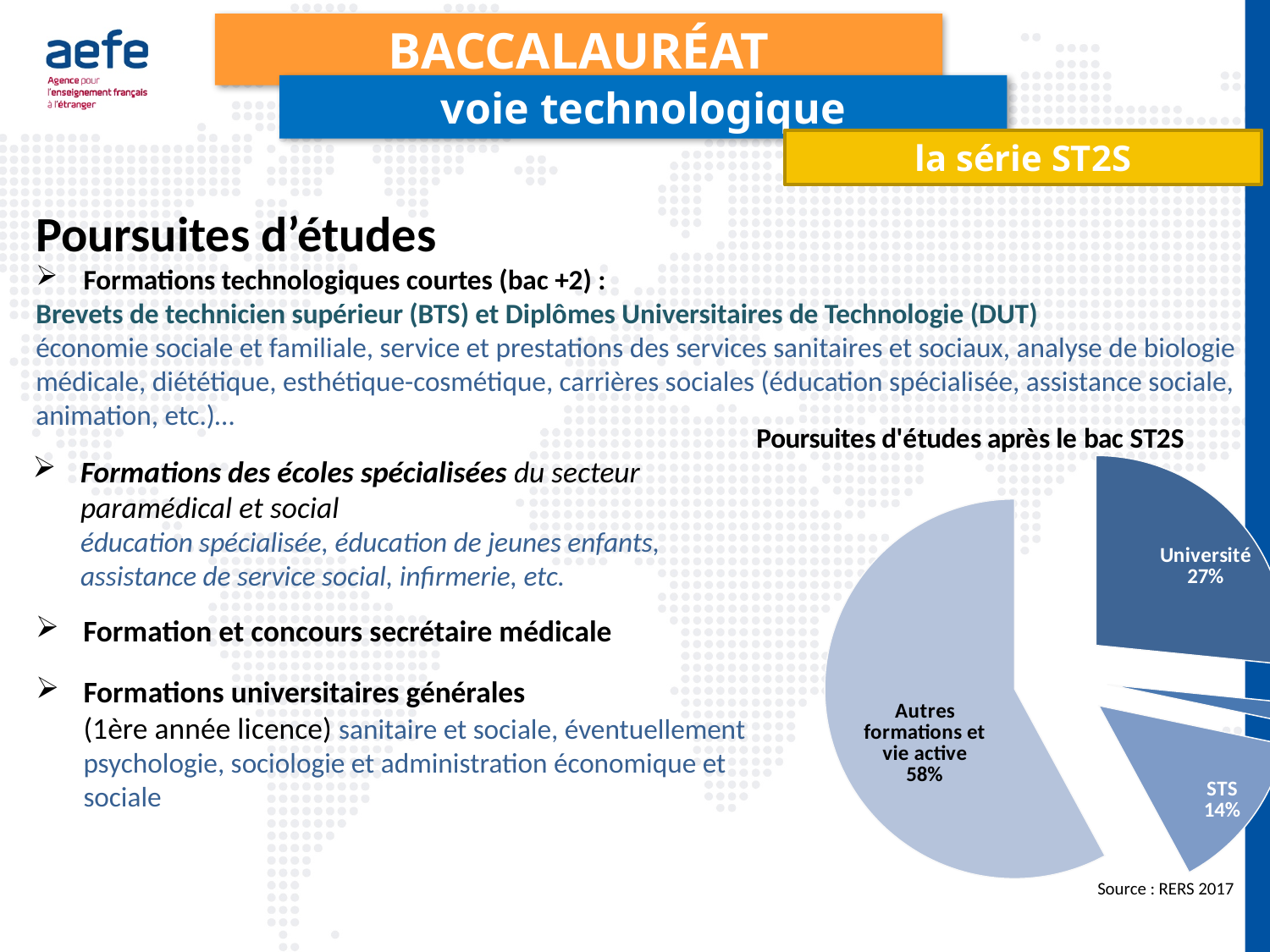
What share of the pie is labelled Autres formations et vie active? 58% What source is cited below the chart? RERS 2017 What is the combined share of the Université and STS slices? 41% What share of the pie is labelled Université? 27% What is the title of the chart? Poursuites d'études après le bac ST2S What is the difference in percentage points between the Autres formations et vie active slice and the Université slice? 31 What share of the pie is labelled STS? 14% What kind of chart is shown on the slide? pie chart Which slice of the pie is the largest? Autres formations et vie active What is the difference in percentage points between the Université slice and the STS slice? 13 Which is larger, the Université slice or the STS slice? Université